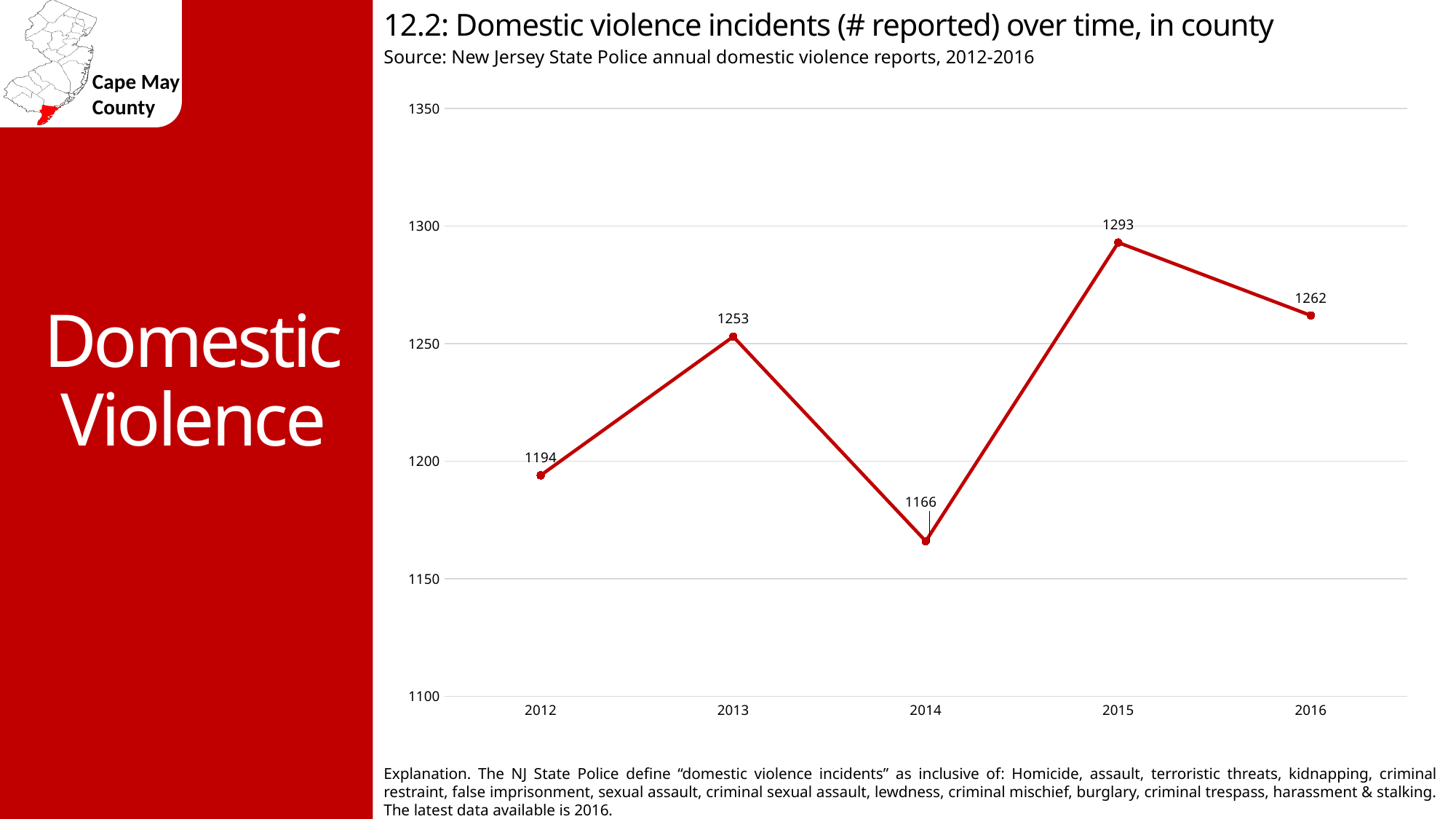
What type of chart is shown on the slide? line chart Which year had the highest number of reported domestic violence incidents? 2015 What is the difference in reported incidents between 2015 and 2014? 127 Is the value for 2016 greater or less than 1250? greater Which year had more reported incidents, 2013 or 2016? 2016 How many years are plotted on the chart? 5 By how much did reported incidents change from 2012 to 2013? 59 What was the number of reported domestic violence incidents in 2012? 1194 Which year had the lowest number of reported domestic violence incidents? 2014 How many domestic violence incidents were reported in 2014? 1166 Did the number of reported incidents rise or fall from 2015 to 2016? fall What is the source of the data shown in the chart? New Jersey State Police annual domestic violence reports, 2012-2016